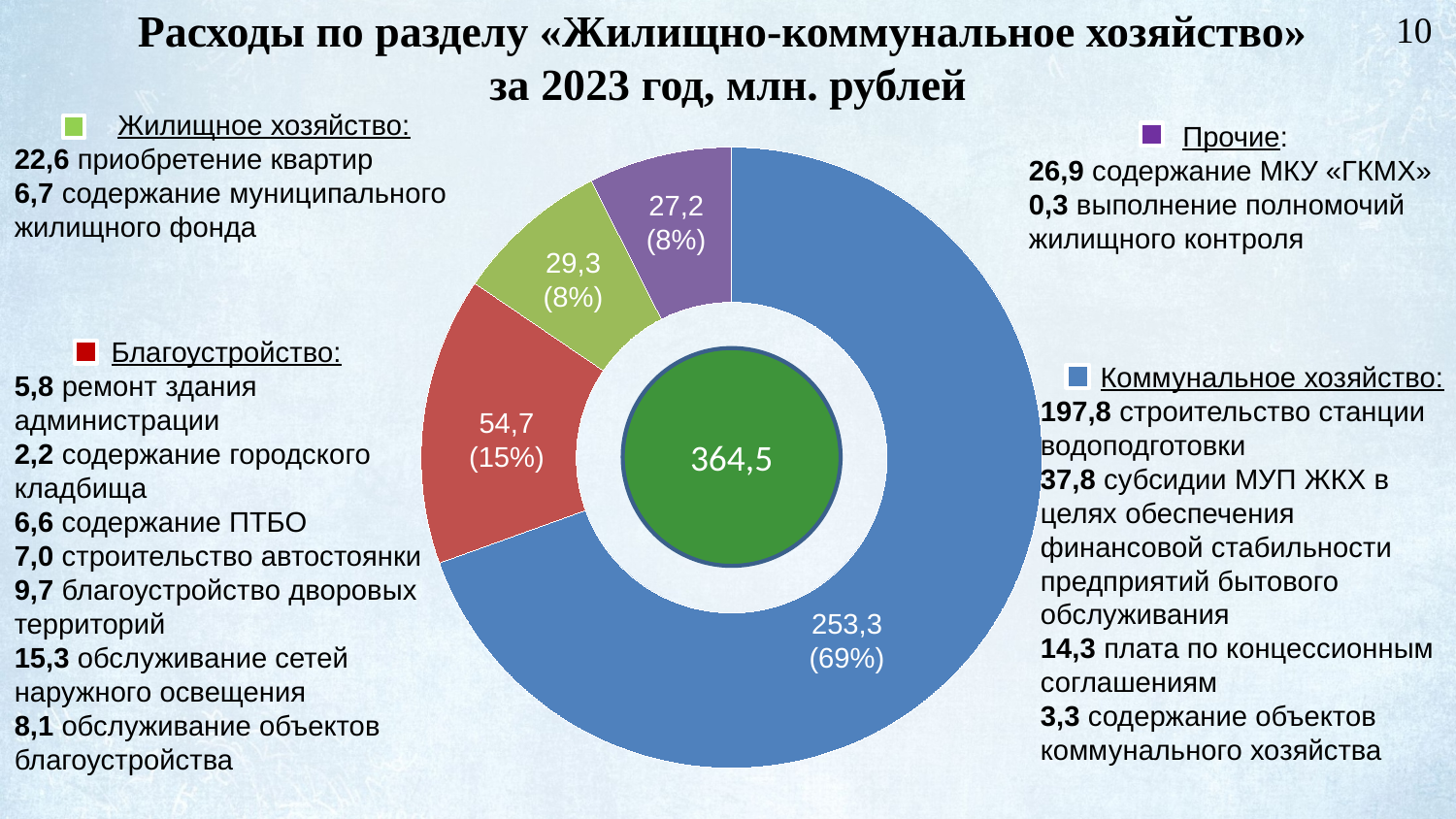
What share of the chart does Коммунальное хозяйство represent? 69% What is the value for Коммунальное хозяйство? 253,3 How many segments does the chart have? 4 What is the difference between the values for Коммунальное хозяйство and Благоустройство? 198,6 What total value is shown in the centre of the chart? 364,5 What kind of chart is shown on the slide? Doughnut (pie) chart What is the value for Благоустройство? 54,7 What is the value for Прочие? 27,2 What is the value for Жилищное хозяйство? 29,3 Which category has the smallest value? Прочие Which category has the largest share of the chart? Коммунальное хозяйство What share of the chart does Благоустройство represent? 15%